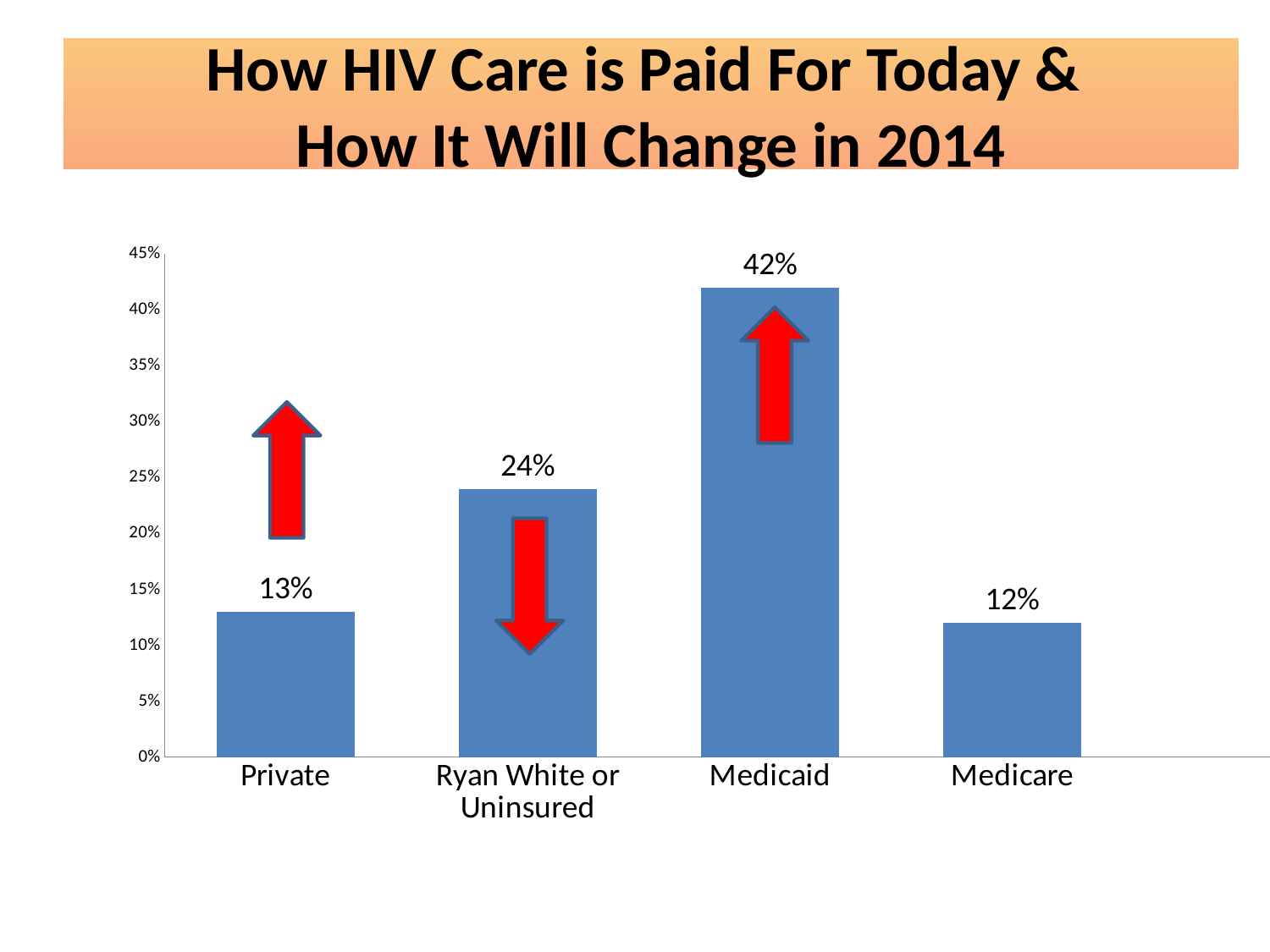
What is the value for Medicare? 12% What kind of chart is shown on the slide? bar chart What is the value for Medicaid? 42% What is the value for Private? 13% Which category has the highest value? Medicaid Which category has the lowest value? Medicare How many categories are shown on the x axis? 4 Which is larger, the value for Private or the value for Ryan White or Uninsured? Ryan White or Uninsured Is the value for Medicaid greater or less than 40%? greater What is the difference between the values for Medicaid and Ryan White or Uninsured? 18% What is the value for Ryan White or Uninsured? 24% Which category has a red downward arrow drawn over its bar? Ryan White or Uninsured